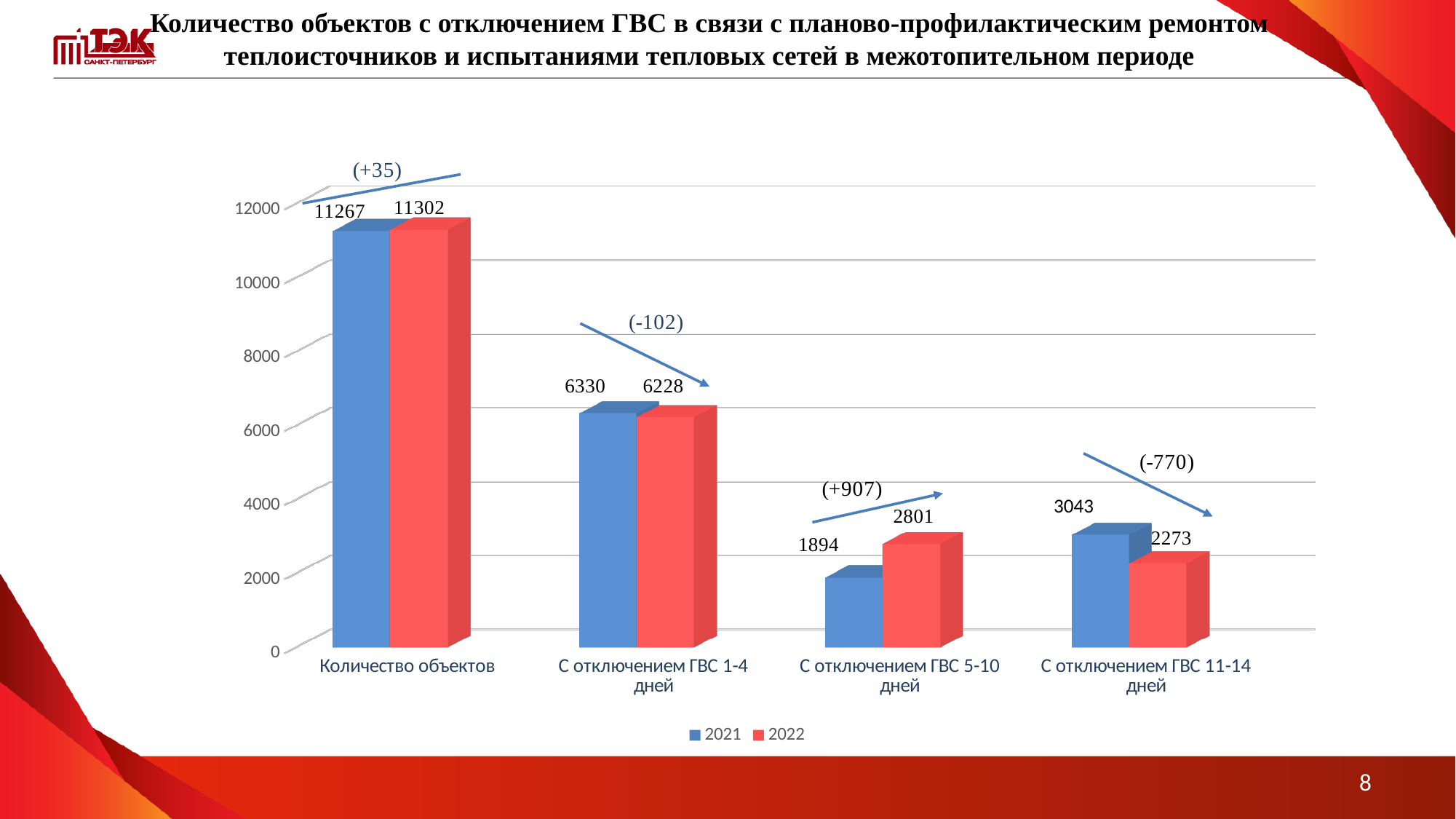
How many series does the legend list? 2 What kind of chart is shown on the slide? Bar chart What is the 2021 value for "Количество объектов"? 11267 What is the 2022 value for "С отключением ГВС 5-10 дней"? 2801 What is the 2021 value for "С отключением ГВС 11-14 дней"? 3043 Which colour represents the 2022 series? Red Which is larger for "С отключением ГВС 5-10 дней": the 2021 value or the 2022 value? 2022 What is the 2022 value for "С отключением ГВС 1-4 дней"? 6228 Which category has the highest 2022 value? Количество объектов Which category has the lowest 2021 value? С отключением ГВС 5-10 дней What is the difference between the 2021 and 2022 values for "С отключением ГВС 11-14 дней"? 770 How many categories are shown on the x axis? 4